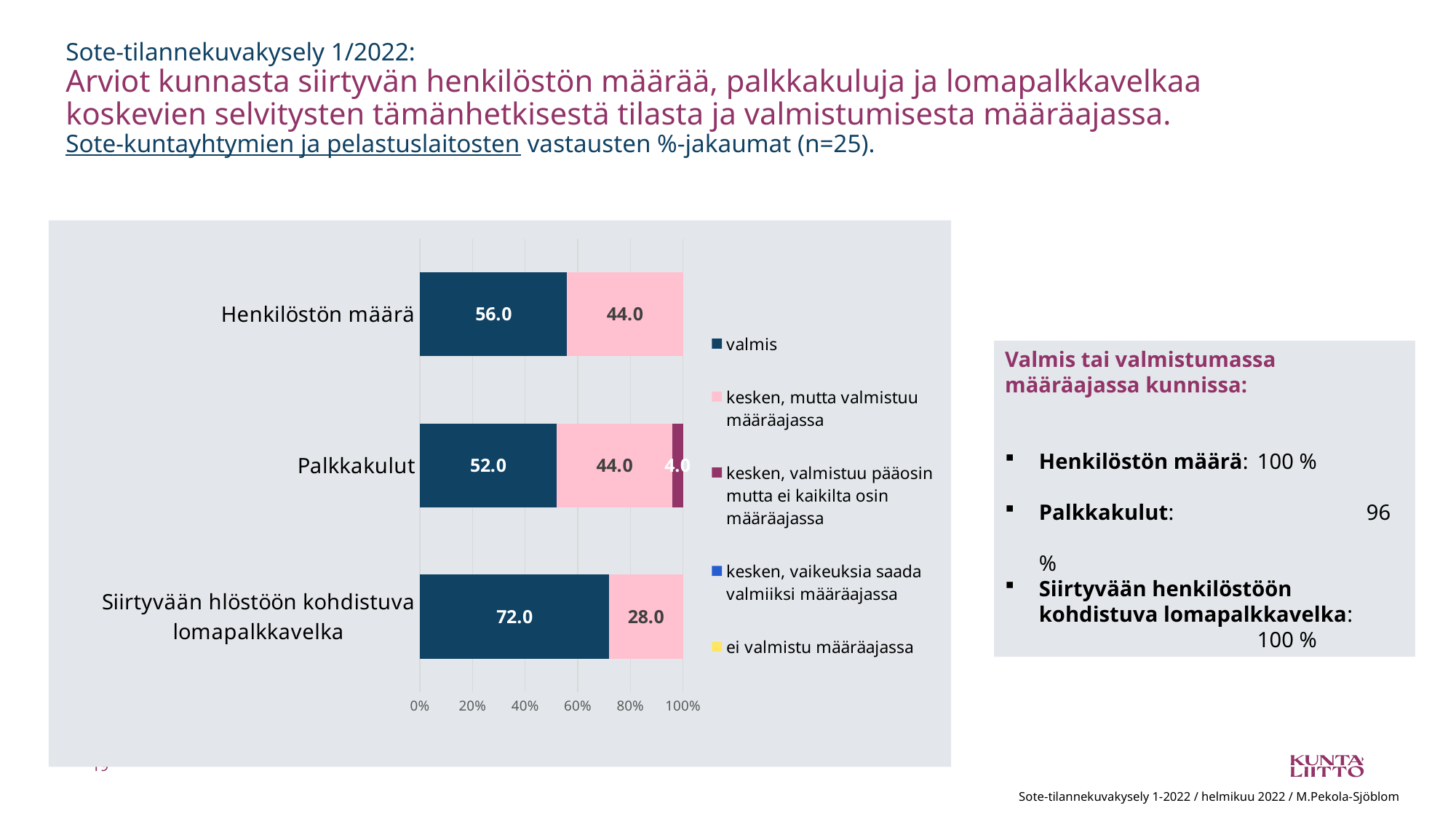
What is the 'kesken, mutta valmistuu määräajassa' value for Palkkakulut? 44.0 How many categories are shown on the chart? 3 What is the 'valmis' value for Siirtyvään hlöstöön kohdistuva lomapalkkavelka? 72.0 What is the 'valmis' value for Henkilöstön määrä? 56.0 What is the total of the stacked bar for Palkkakulut? 100.0 Which category has the highest 'valmis' value? Siirtyvään hlöstöön kohdistuva lomapalkkavelka Which category has the lowest 'valmis' value? Palkkakulut What is the 'kesken, valmistuu pääosin mutta ei kaikilta osin määräajassa' value for Palkkakulut? 4.0 What is the difference between the 'valmis' values for Siirtyvään hlöstöön kohdistuva lomapalkkavelka and Henkilöstön määrä? 16.0 How many series does the legend list? 5 What kind of chart is shown on the slide? Stacked bar chart Which is larger: the 'kesken, mutta valmistuu määräajassa' value for Henkilöstön määrä or for Siirtyvään hlöstöön kohdistuva lomapalkkavelka? Henkilöstön määrä